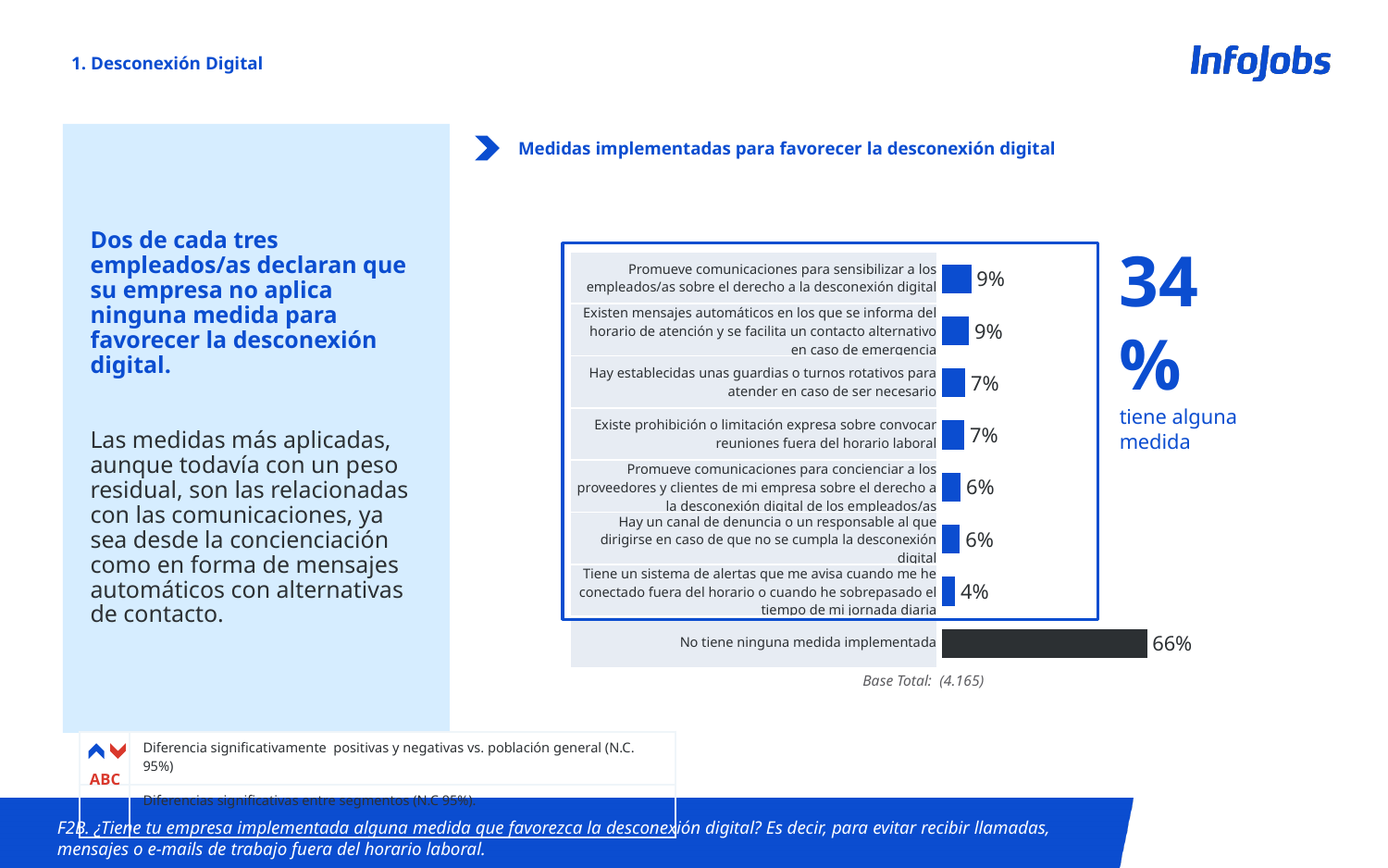
What kind of chart is shown on the slide? Bar chart What percentage is shown for "Hay establecidas unas guardias o turnos rotativos para atender en caso de ser necesario"? 7% How many categories are plotted in the chart? 8 What is the title of the chart? Medidas implementadas para favorecer la desconexión digital What is the base total shown below the chart? 4.165 What is the difference in percentage points between "No tiene ninguna medida implementada" and "Tiene un sistema de alertas..."? 62 percentage points Which category has the highest value in the chart? No tiene ninguna medida implementada Which is larger: the value for "Promueve comunicaciones para sensibilizar a los empleados/as sobre el derecho a la desconexión digital" or the value for "Hay un canal de denuncia o un responsable al que dirigirse en caso de que no se cumpla la desconexión digital"? Promueve comunicaciones para sensibilizar a los empleados/as sobre el derecho a la desconexión digital What percentage is shown for "Existen mensajes automáticos en los que se informa del horario de atención y se facilita un contacto alternativo en caso de emergencia"? 9% Which category has the lowest value in the chart? Tiene un sistema de alertas que me avisa cuando me he conectado fuera del horario o cuando he sobrepasado el tiempo de mi jornada diaria What percentage is shown for "Tiene un sistema de alertas que me avisa cuando me he conectado fuera del horario o cuando he sobrepasado el tiempo de mi jornada diaria"? 4% What percentage is shown for "No tiene ninguna medida implementada"? 66%